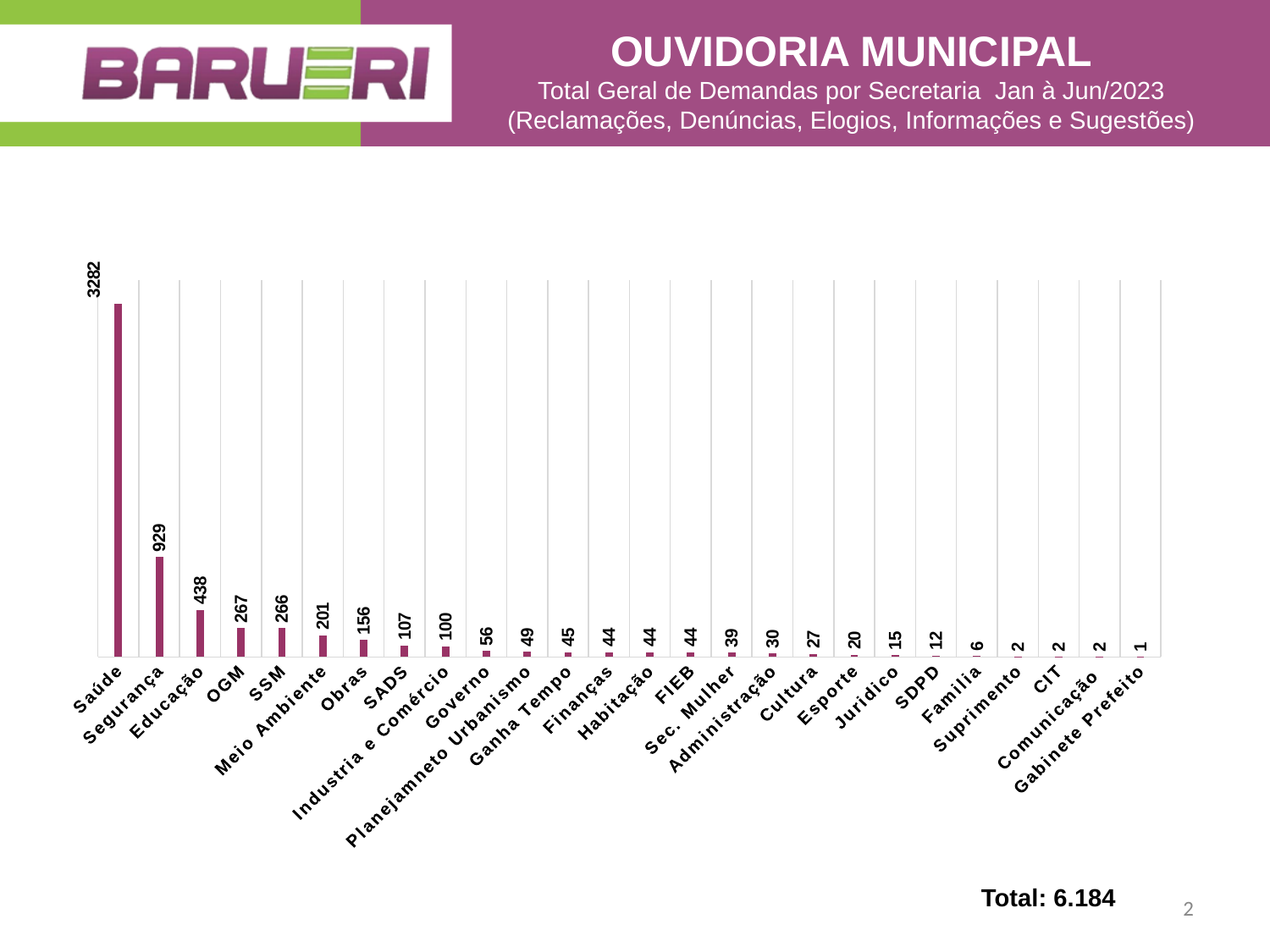
What is the difference between the values for Saúde and Segurança? 2353 Which category has the highest value? Saúde Which category has the lowest value? Gabinete Prefeito What is the value for Sec. Mulher? 39 What is the difference between the values for Educação and OGM? 171 Do the values rise or fall from left to right along the x axis? Fall What kind of chart is shown on the slide? Bar chart What is the value for Meio Ambiente? 201 How many categories are shown in the chart? 26 What is the value for Segurança? 929 Which is larger, the value for Obras or the value for SADS? Obras What is the value for Saúde? 3282